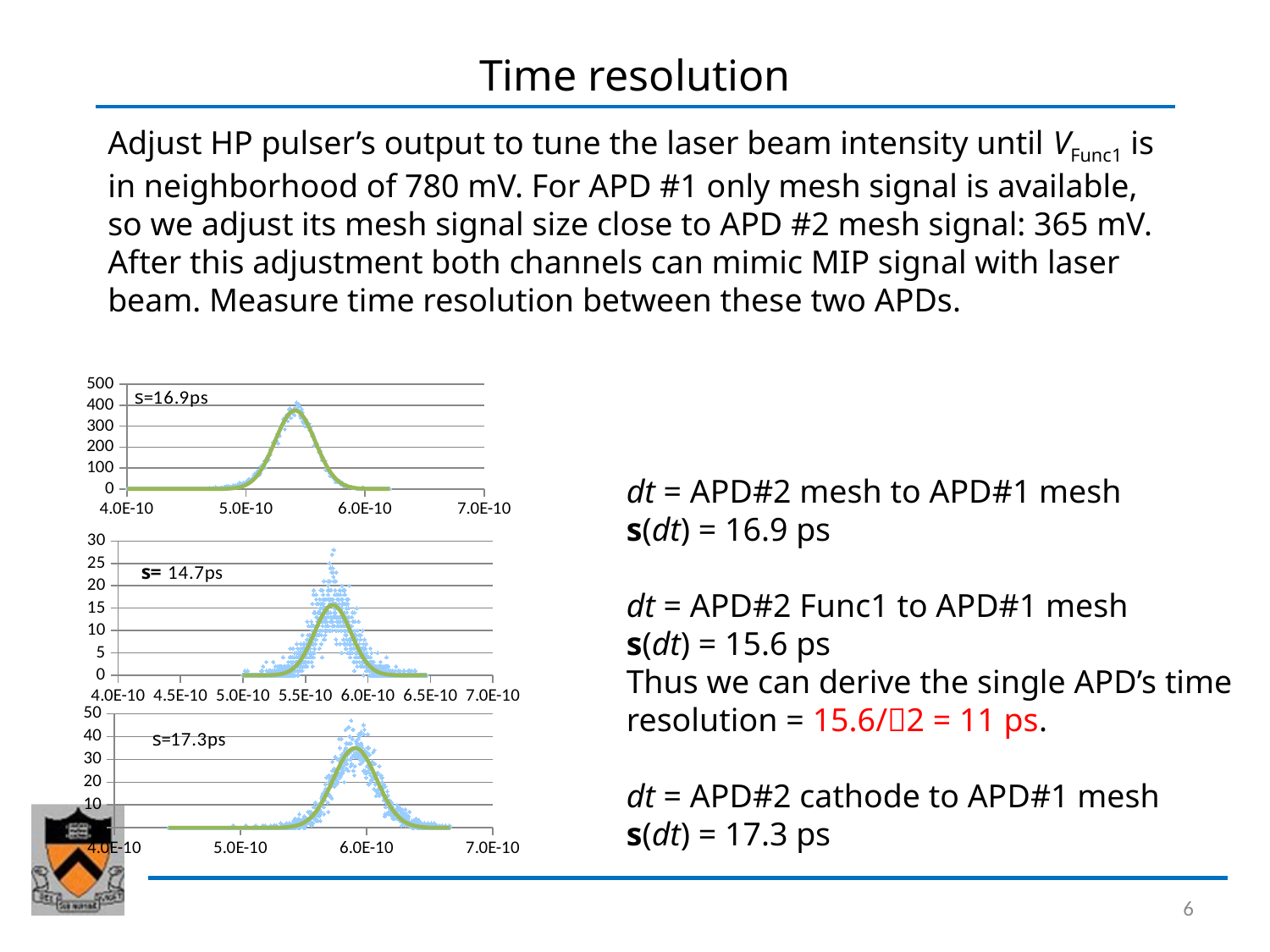
What kind of chart is the top chart on the left of the slide? scatter chart with a fitted curve Which chart has the highest peak value: the top, middle, or bottom chart? top In the top chart, is the peak of the fitted curve greater or less than 300? greater What sigma value is annotated on the top chart? s=16.9ps What is the maximum value shown on the y axis of the bottom chart? 50 What is the maximum value shown on the y axis of the top chart? 500 What is the maximum value shown on the y axis of the middle chart? 30 In the bottom chart, is the peak of the fitted curve greater or less than 20? greater How many charts are shown on the slide? 3 What sigma value is annotated on the bottom chart? s=17.3ps In the middle chart, is the peak of the fitted curve greater or less than 20? less What sigma value is annotated on the middle chart? s= 14.7ps